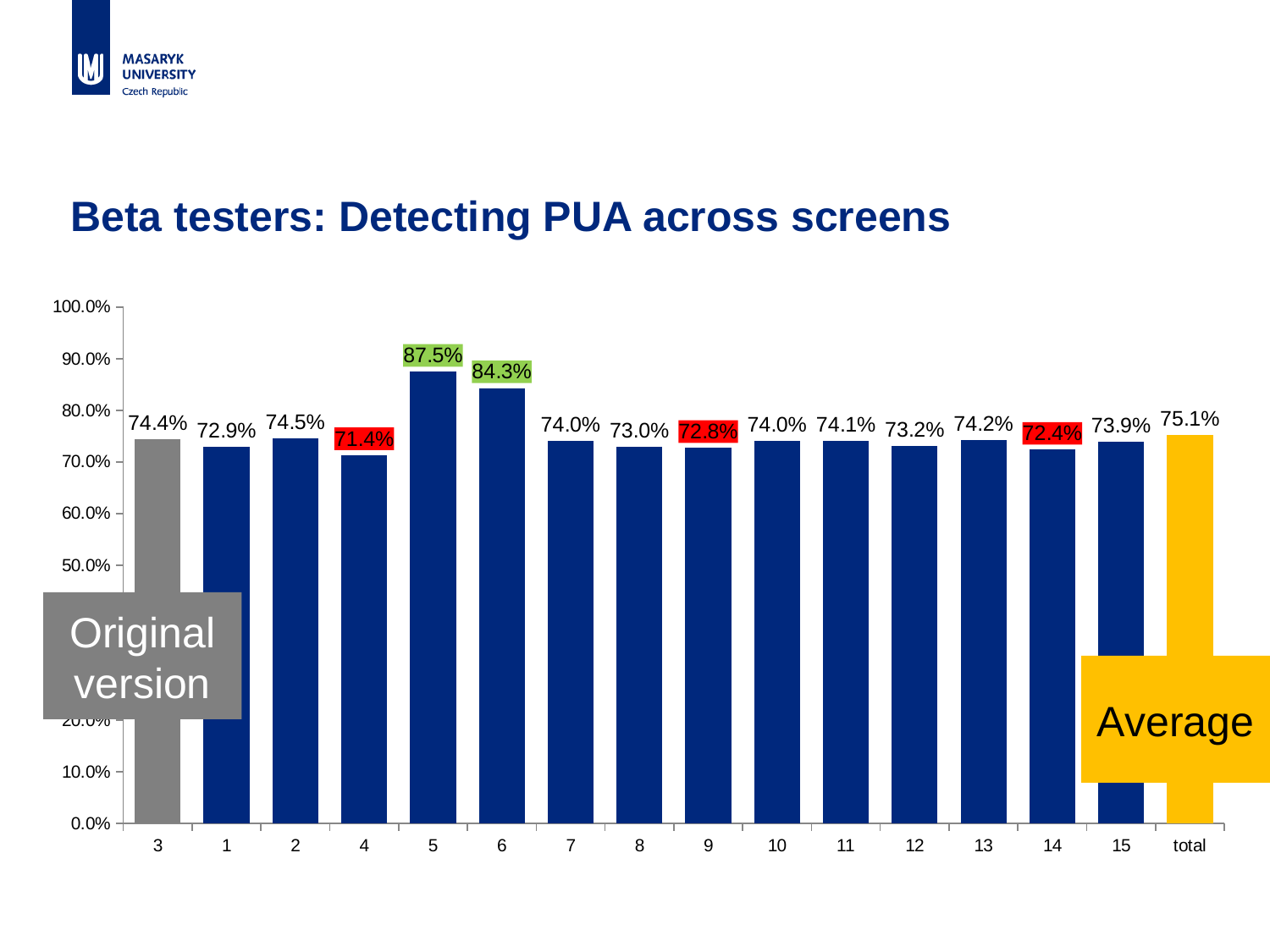
What is the value for screen 3, labelled as the original version? 74.4% What is the difference between the values for screen 5 and screen 6? 3.2 percentage points Is the value for screen 5 greater or less than 80.0%? greater Which is larger, the value for screen 6 or the value for screen 4? Screen 6 What is the value for screen 5? 87.5% What is the value for the 'total' bar? 75.1% What kind of chart is shown on the slide? Bar chart What is the difference between the value for screen 5 and the 'total' bar? 12.4 percentage points Which screen has the lowest detection rate? 4 Which screen has the highest detection rate? 5 How many bars are shown in the chart? 16 What is the value for screen 14? 72.4%